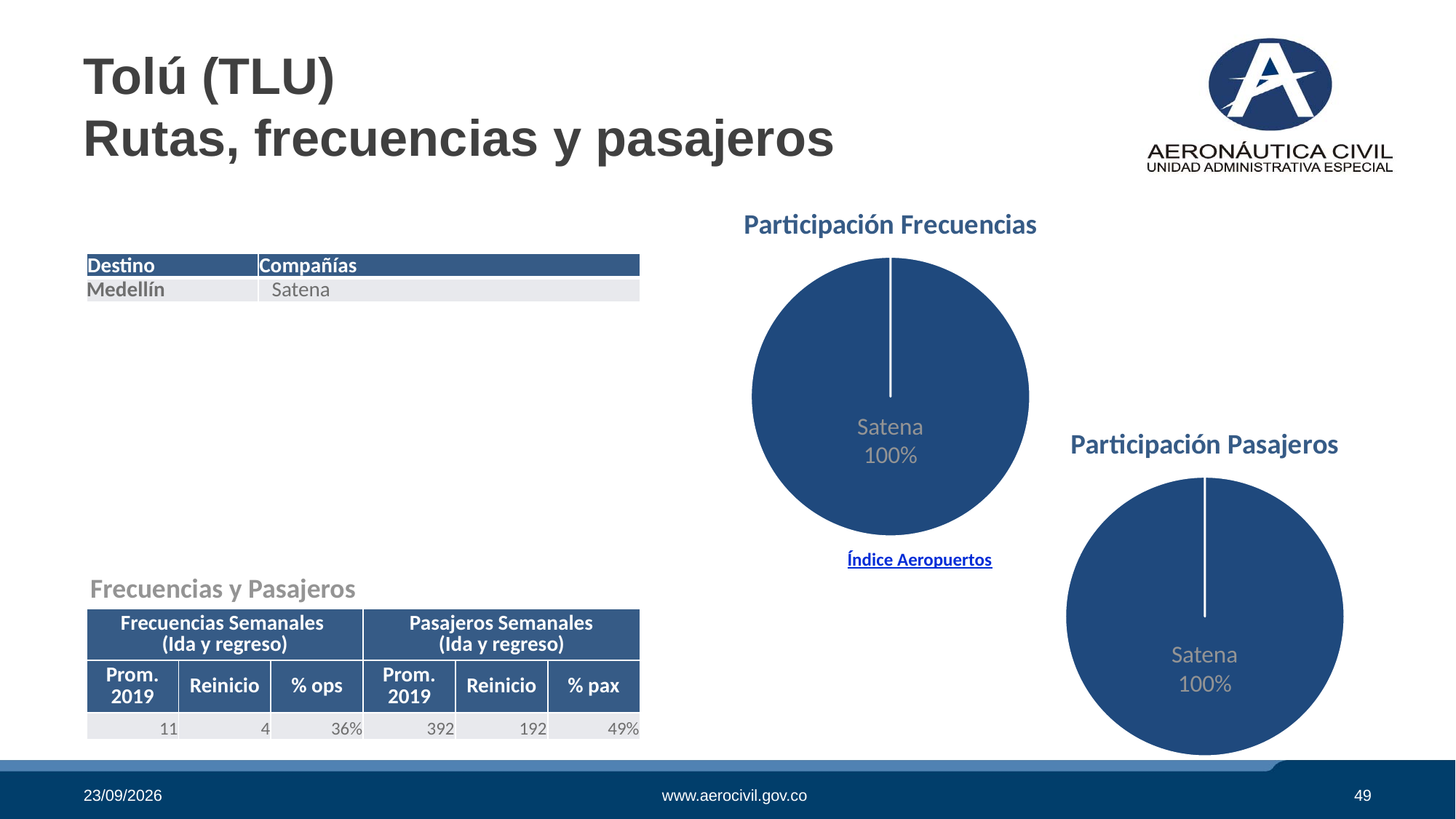
In the 'Participación Pasajeros' chart, which company is labelled on the pie? Satena In the 'Participación Frecuencias' chart, which company is labelled on the pie? Satena In the 'Participación Pasajeros' chart, what share does Satena have? 100% What is the title of the upper pie chart on the slide? Participación Frecuencias What is the title of the pie chart on the right side of the slide, lower position? Participación Pasajeros How many slices does the 'Participación Frecuencias' pie chart have? 1 How many slices does the 'Participación Pasajeros' pie chart have? 1 In the 'Participación Frecuencias' chart, what share does Satena have? 100% What kind of chart is 'Participación Frecuencias'? pie chart What kind of chart is 'Participación Pasajeros'? pie chart